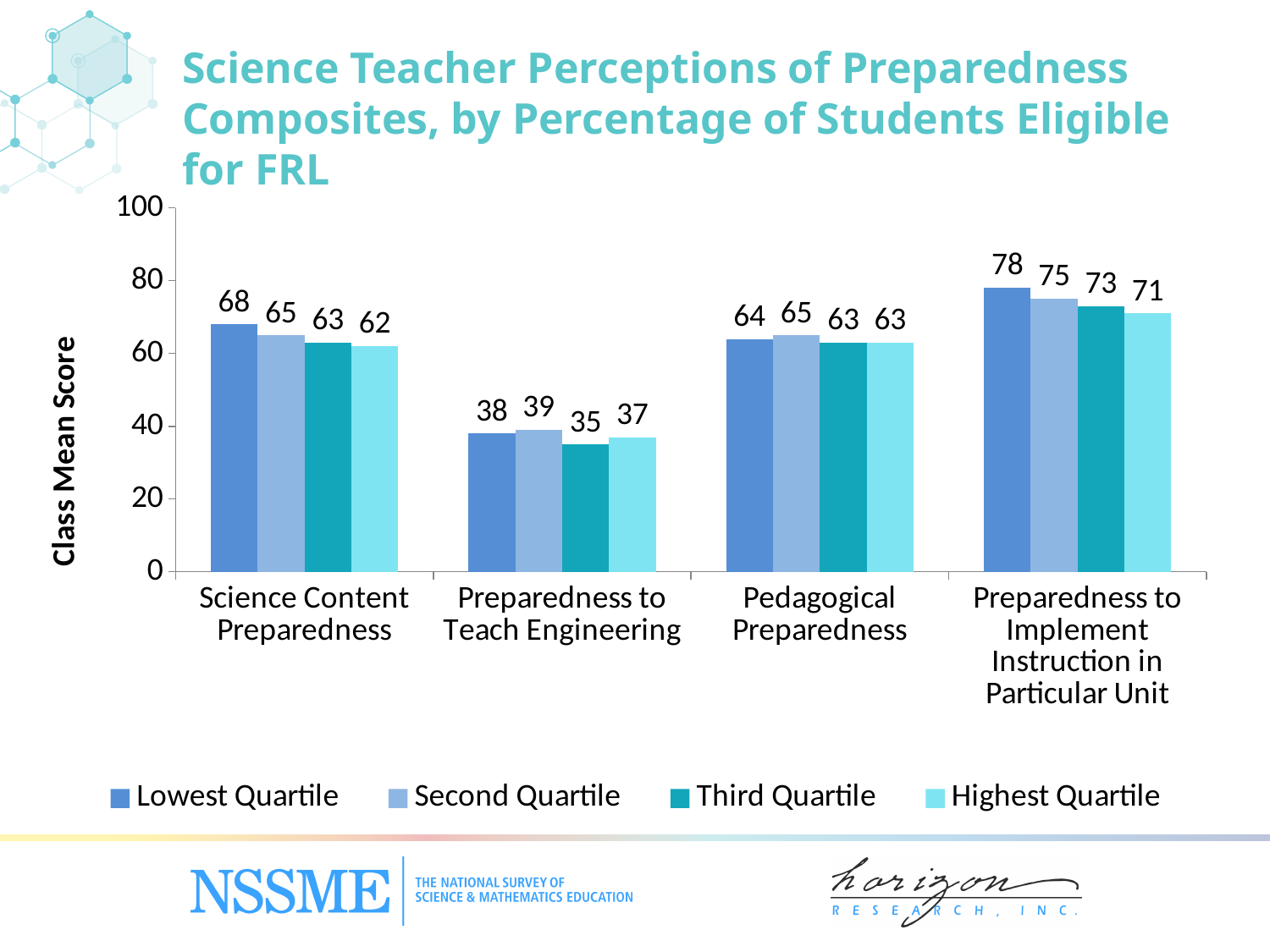
What is the Class Mean Score for the Highest Quartile on Preparedness to Implement Instruction in Particular Unit? 71 What is the Class Mean Score for the Third Quartile on Preparedness to Teach Engineering? 35 How many series does the legend list? 4 Which category has the lowest Class Mean Score for the Second Quartile? Preparedness to Teach Engineering Which category has the highest Class Mean Score for the Lowest Quartile? Preparedness to Implement Instruction in Particular Unit Is the Third Quartile value for Preparedness to Teach Engineering greater or less than 40? less What kind of chart is shown on the slide? bar chart What is the Class Mean Score for the Lowest Quartile on Science Content Preparedness? 68 What is the difference between the Lowest Quartile and Highest Quartile scores for Preparedness to Implement Instruction in Particular Unit? 7 What is the label of the y axis? Class Mean Score Which is larger for Pedagogical Preparedness: the Lowest Quartile score or the Second Quartile score? Second Quartile How many categories are shown on the x axis? 4